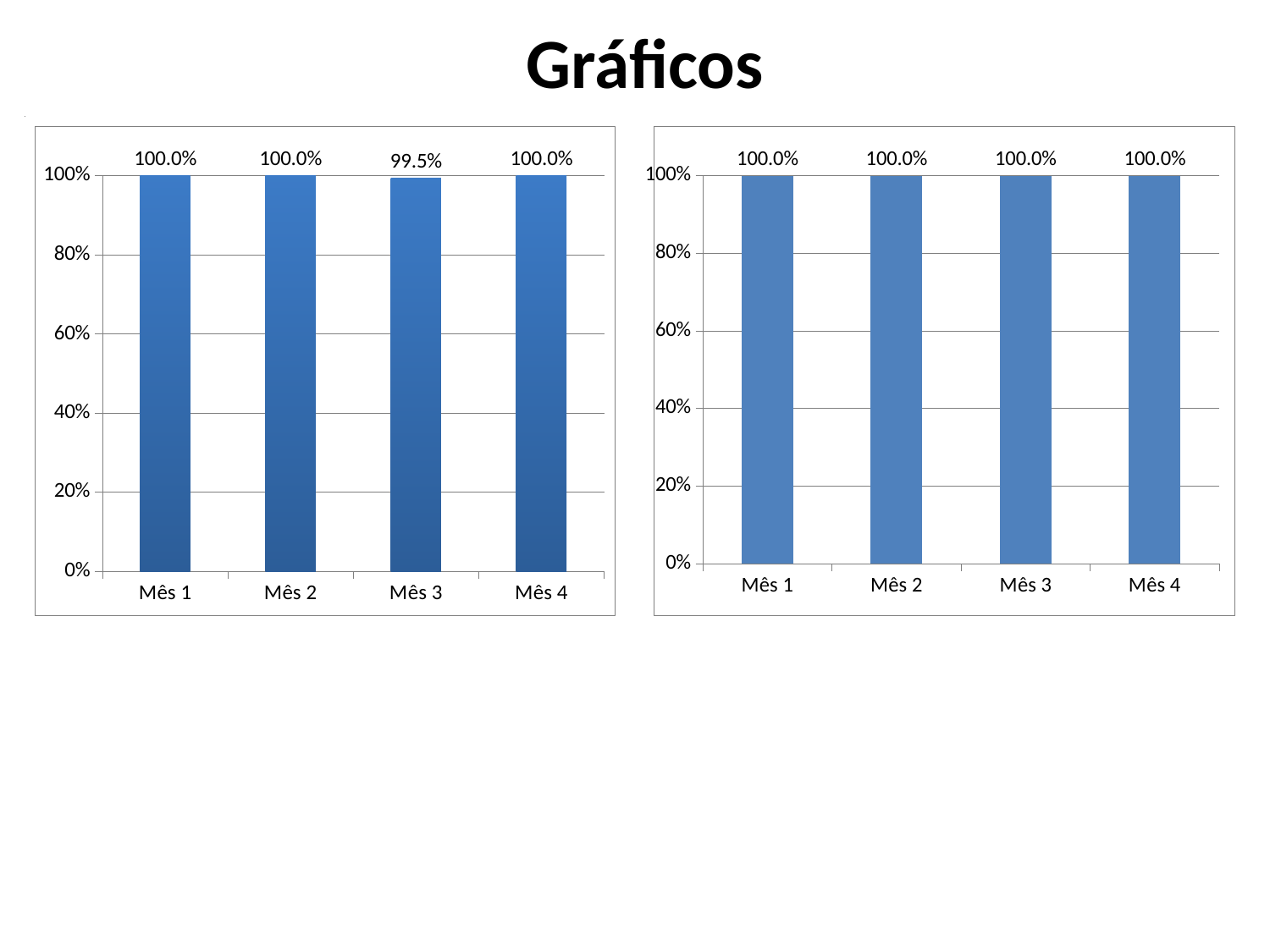
What kind of chart is the right chart? bar chart In the right chart, do the values change from Mês 1 to Mês 4? No, they stay at 100.0% In the right chart, is the value for Mês 2 greater or less than 80%? greater In the right chart, what is the value for Mês 4? 100.0% What is the title of the slide? Gráficos In the left chart, which month has the lowest value? Mês 3 In the left chart, which is larger, the value for Mês 1 or the value for Mês 3? Mês 1 How many categories are shown in the right chart? 4 How many bars are shown in the left chart? 4 In the left chart, what is the value for Mês 3? 99.5% In the left chart, what is the difference between the values for Mês 2 and Mês 3? 0.5% In the left chart, what is the value for Mês 1? 100.0%